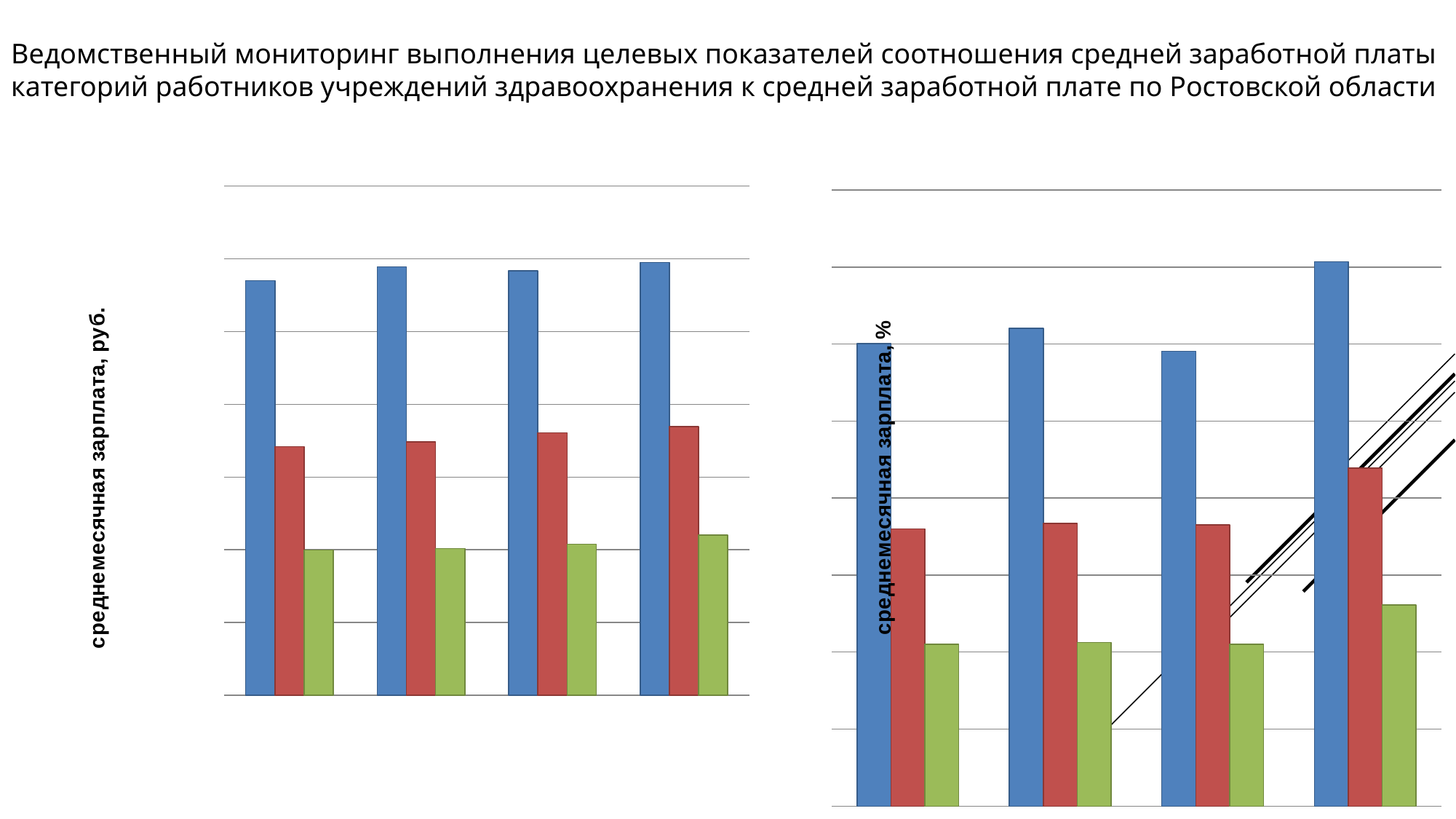
In the right chart, which group has the tallest blue bar? the fourth (rightmost) group What is the vertical axis title of the right chart? среднемесячная зарплата, % What kind of chart is the right chart on the slide? bar chart In the right chart, which group has the shortest blue bar? the third group In the right chart, how many groups of bars are plotted? 4 In the left chart, how many bars are there in each group? 3 What kind of chart is the left chart on the slide? bar chart In the right chart, which group has the tallest green bar? the fourth (rightmost) group What is the vertical axis title of the left chart? среднемесячная зарплата, руб. In the left chart, how many groups of bars are plotted? 4 In the left chart, which colour bar is the shortest in every group? green In the left chart, which colour bar is the tallest in every group? blue